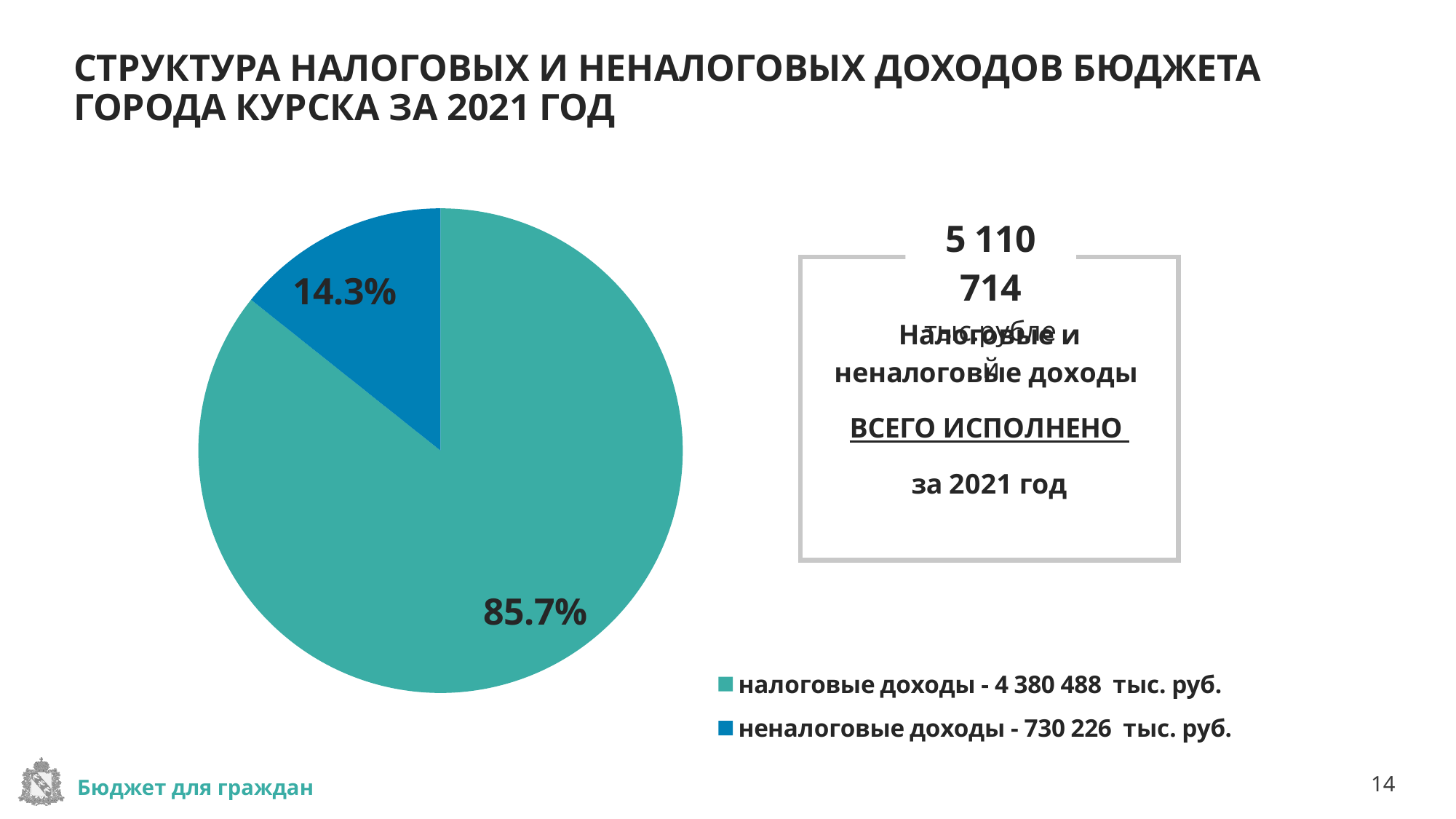
How many entries does the legend list? 2 What is the difference in percentage points between the налоговые доходы and неналоговые доходы slices? 71.4 What share of the pie is неналоговые доходы? 14.3% How many slices does the pie chart have? 2 Which slice is the smallest? неналоговые доходы What is the value for налоговые доходы given in the legend? 4 380 488 тыс. руб. What is the value for неналоговые доходы given in the legend? 730 226 тыс. руб. Which slice is the largest? налоговые доходы What colour is the неналоговые доходы slice? blue What kind of chart is shown on the slide? pie chart What share of the pie is налоговые доходы? 85.7% Which is larger, налоговые доходы or неналоговые доходы? налоговые доходы